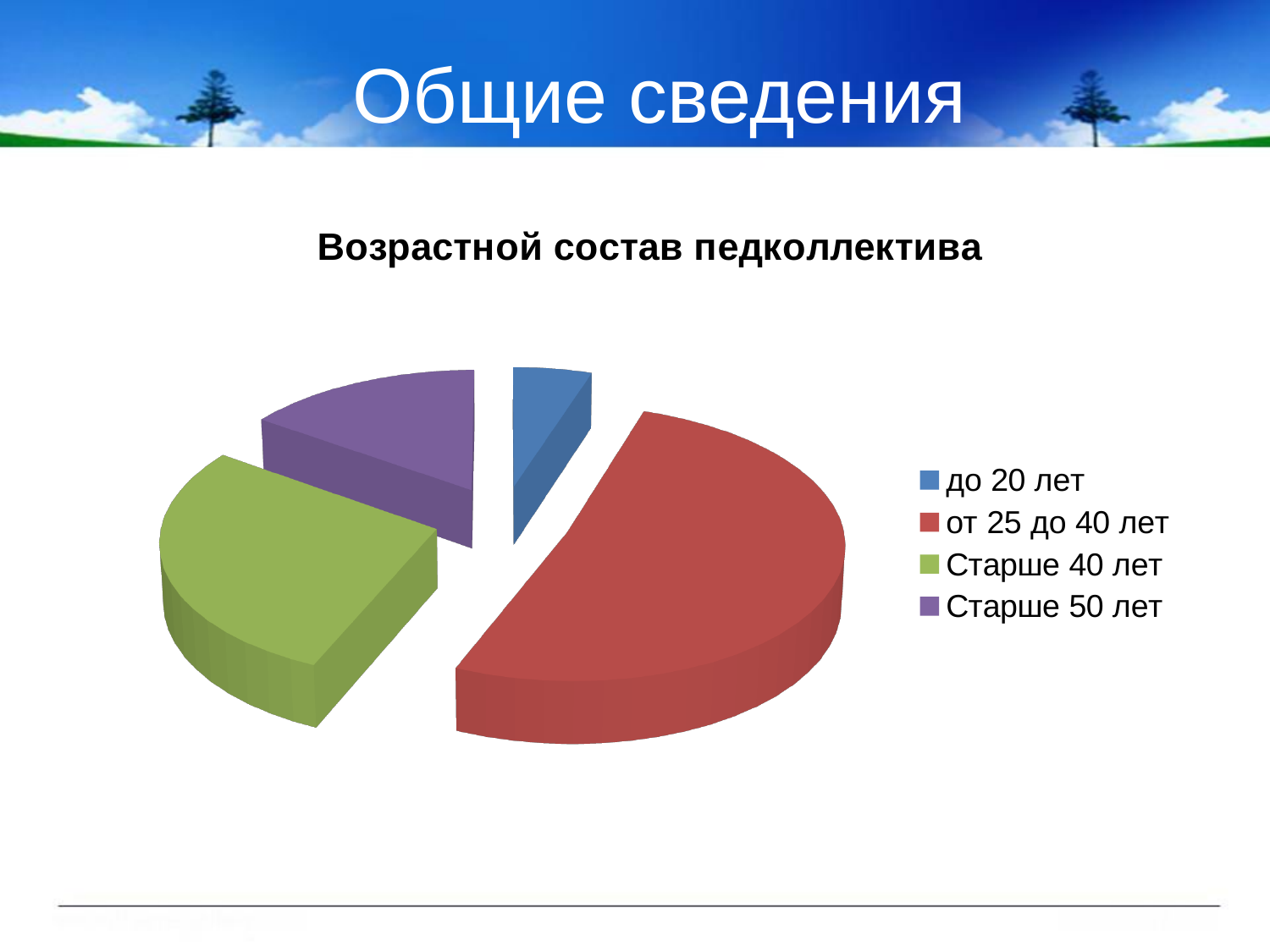
What is the title of the chart? Возрастной состав педколлектива What colour is the slice for 'Старше 40 лет'? Green Which age group has the largest slice of the pie? от 25 до 40 лет Which slice is larger: 'Старше 40 лет' or 'Старше 50 лет'? Старше 40 лет How many entries does the legend list? 4 What kind of chart is shown on the slide? Pie chart How many categories (slices) does the pie chart have? 4 Which slice is larger: 'до 20 лет' or 'от 25 до 40 лет'? от 25 до 40 лет Which slice is larger: 'Старше 50 лет' or 'до 20 лет'? Старше 50 лет Which age group has the smallest slice of the pie? до 20 лет